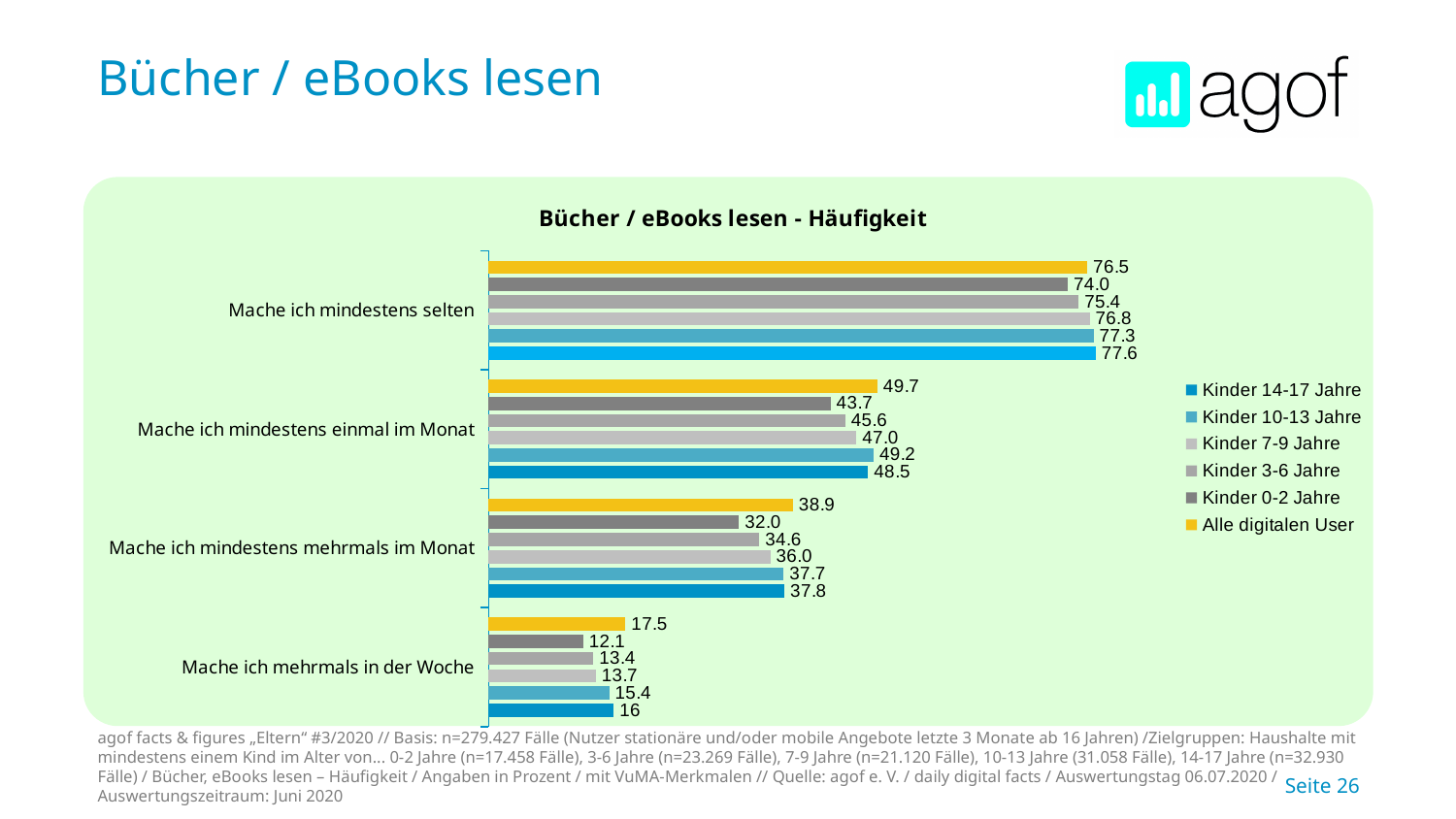
Which category has the highest values across all series? Mache ich mindestens selten How many categories are shown on the chart? 4 What is the value for Kinder 14-17 Jahre in the category 'Mache ich mindestens einmal im Monat'? 48.5 What is the value for Kinder 0-2 Jahre in the category 'Mache ich mehrmals in der Woche'? 12.1 What is the value for Alle digitalen User in the category 'Mache ich mindestens selten'? 76.5 What is the title of the chart? Bücher / eBooks lesen - Häufigkeit Which series has the highest value in the category 'Mache ich mehrmals in der Woche'? Alle digitalen User What type of chart is shown on the slide? bar chart What is the difference between Alle digitalen User and Kinder 0-2 Jahre in the category 'Mache ich mindestens einmal im Monat'? 6.0 Which series has the lowest value in the category 'Mache ich mindestens mehrmals im Monat'? Kinder 0-2 Jahre How many series does the legend list? 6 In the category 'Mache ich mehrmals in der Woche', which is larger: Kinder 10-13 Jahre or Kinder 7-9 Jahre? Kinder 10-13 Jahre